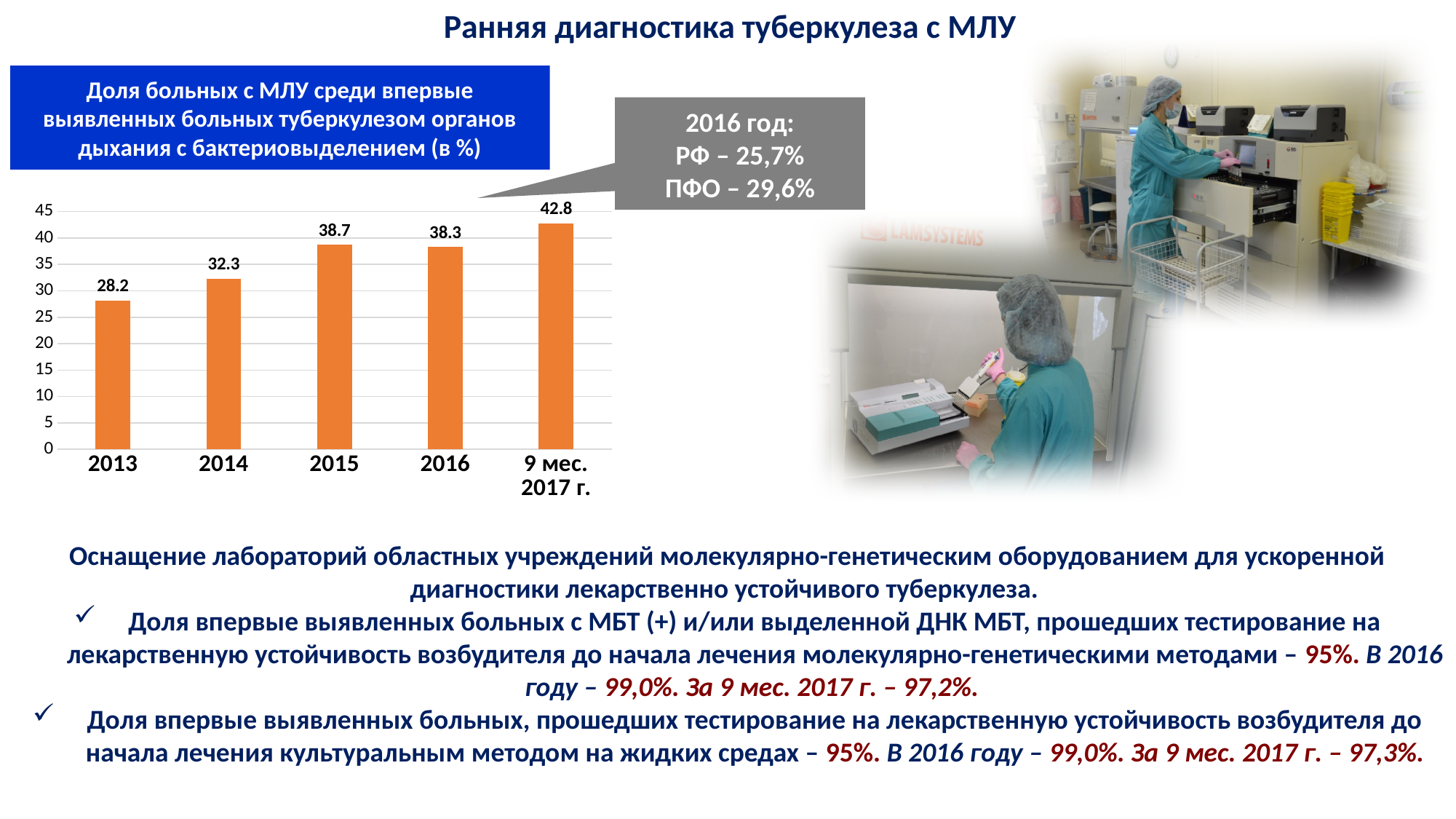
How many categories are shown on the x axis? 5 Do the values generally rise or fall from 2013 to 9 мес. 2017 г.? rise Which is larger, the value for 2015 or the value for 2016? 2015 What is the difference between the values for 9 мес. 2017 г. and 2016? 4.5 Which category has the lowest value? 2013 What is the value for 2013? 28.2 What is the value for 9 мес. 2017 г.? 42.8 What is the value for 2016? 38.3 Is the value for 2014 greater or less than 30? greater What is the difference between the values for 2014 and 2013? 4.1 What kind of chart is shown on the slide? bar chart Which category has the highest value? 9 мес. 2017 г.